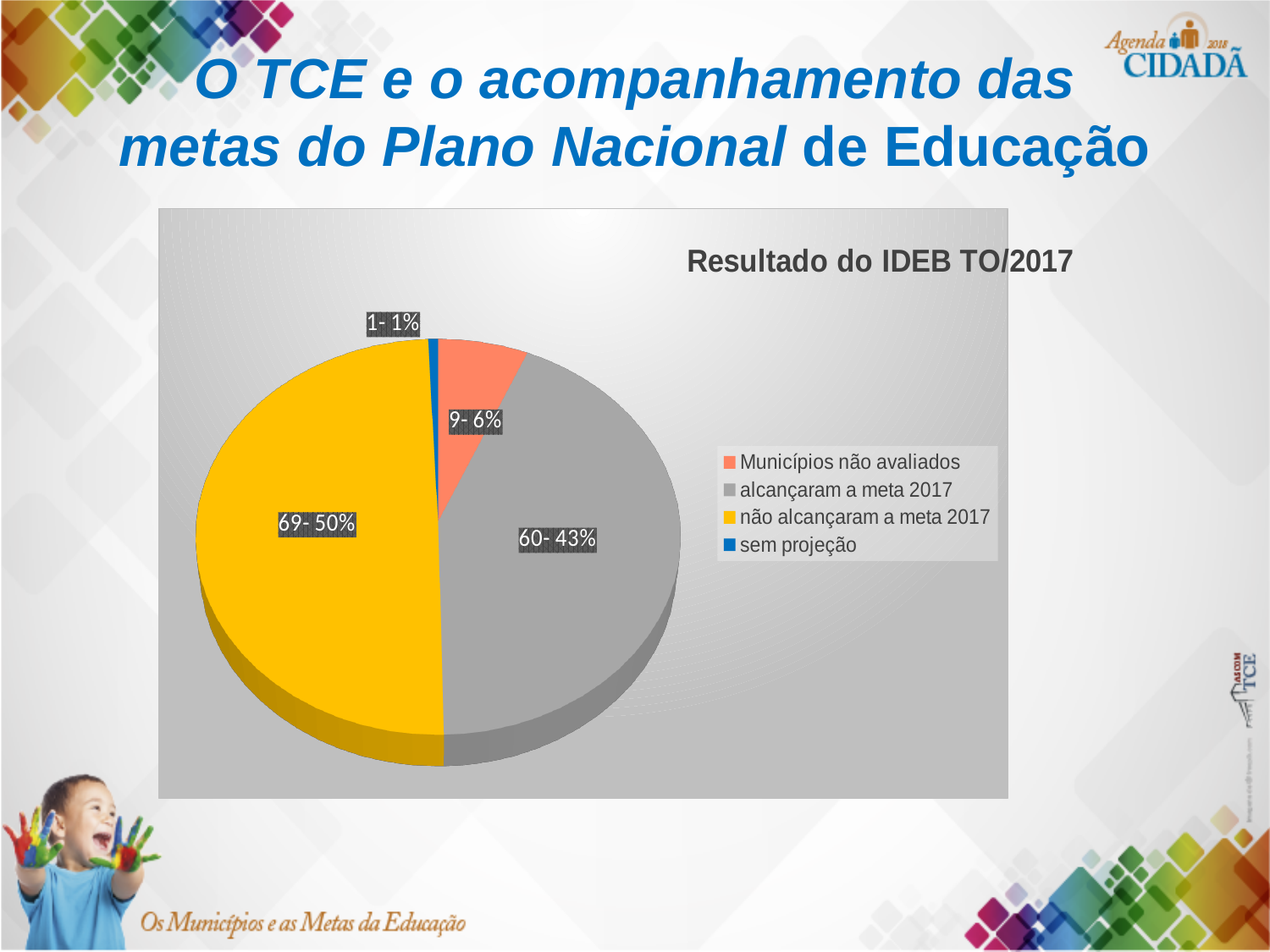
What is the title of the chart? Resultado do IDEB TO/2017 What is the data label shown for the 'alcançaram a meta 2017' slice? 60- 43% How many categories does the legend of the chart list? 4 What is the data label shown for the 'não alcançaram a meta 2017' slice? 69- 50% What type of chart is shown on the slide? pie chart What is the data label shown for the 'sem projeção' slice? 1- 1% What colour is the 'não alcançaram a meta 2017' slice? yellow Which is larger: the share for 'alcançaram a meta 2017' or the share for 'Municípios não avaliados'? alcançaram a meta 2017 Which category has the smallest share of the pie? sem projeção What percentage share of the pie does 'alcançaram a meta 2017' represent? 43% What is the data label shown for the 'Municípios não avaliados' slice? 9- 6% Which category has the largest share of the pie? não alcançaram a meta 2017